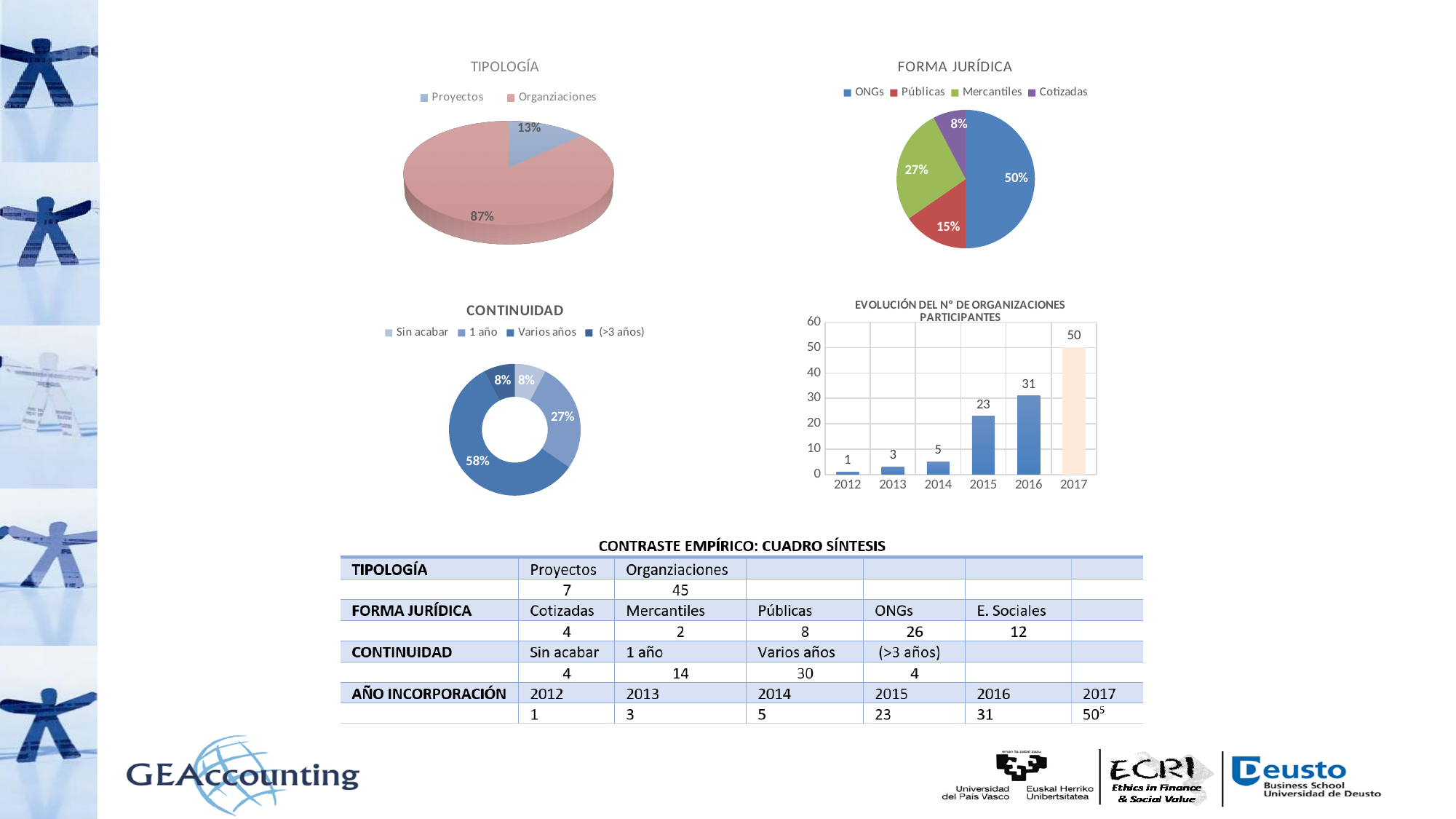
In the FORMA JURÍDICA chart, what percentage is shown for Mercantiles? 27% In the EVOLUCIÓN DEL Nº DE ORGANIZACIONES PARTICIPANTES chart, what is the difference between the values for 2017 and 2016? 19 In the FORMA JURÍDICA chart, which category has the smallest share? Cotizadas In the EVOLUCIÓN DEL Nº DE ORGANIZACIONES PARTICIPANTES chart, what is the value for 2015? 23 In the FORMA JURÍDICA chart, which category has the largest share? ONGs What kind of chart is the CONTINUIDAD chart? Doughnut chart In the CONTINUIDAD chart, what is the difference between the shares for Varios años and 1 año? 31% In the FORMA JURÍDICA chart, how many categories does the legend list? 4 In the TIPOLOGÍA chart, what percentage is shown for Organziaciones? 87% In the EVOLUCIÓN DEL Nº DE ORGANIZACIONES PARTICIPANTES chart, do the values rise or fall from 2012 to 2017? Rise In the CONTINUIDAD chart, what percentage is shown for Varios años? 58% In the TIPOLOGÍA chart, what percentage is shown for Proyectos? 13%